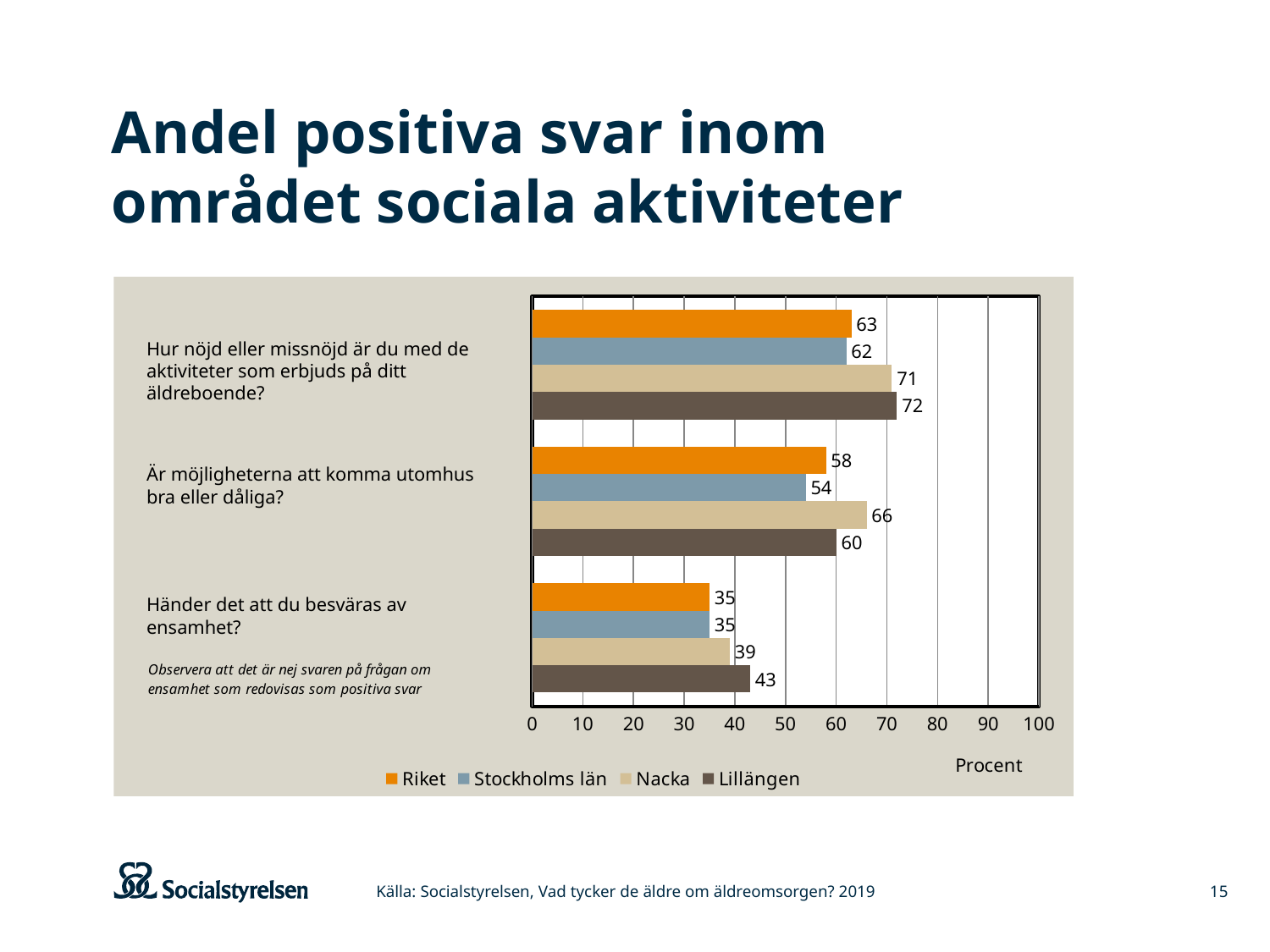
How many series does the legend list? 4 What is the difference between Lillängen and Riket on the question "Händer det att du besväras av ensamhet?"? 8 What unit is shown on the horizontal axis of the chart? Procent Which series has the lowest value on the question "Hur nöjd eller missnöjd är du med de aktiviteter som erbjuds på ditt äldreboende?"? Stockholms län What is the value for Stockholms län on the question "Är möjligheterna att komma utomhus bra eller dåliga?"? 54 Which is larger on the question "Är möjligheterna att komma utomhus bra eller dåliga?": Riket or Lillängen? Lillängen What kind of chart is shown on the slide? Bar chart What is the value for Nacka on the question "Händer det att du besväras av ensamhet?"? 39 How many questions (categories) are shown on the chart? 3 Which series has the highest value on the question "Är möjligheterna att komma utomhus bra eller dåliga?"? Nacka Is the value for Nacka on the question "Hur nöjd eller missnöjd är du med de aktiviteter som erbjuds på ditt äldreboende?" greater or less than 60? greater What is the value for Lillängen on the question "Hur nöjd eller missnöjd är du med de aktiviteter som erbjuds på ditt äldreboende?"? 72